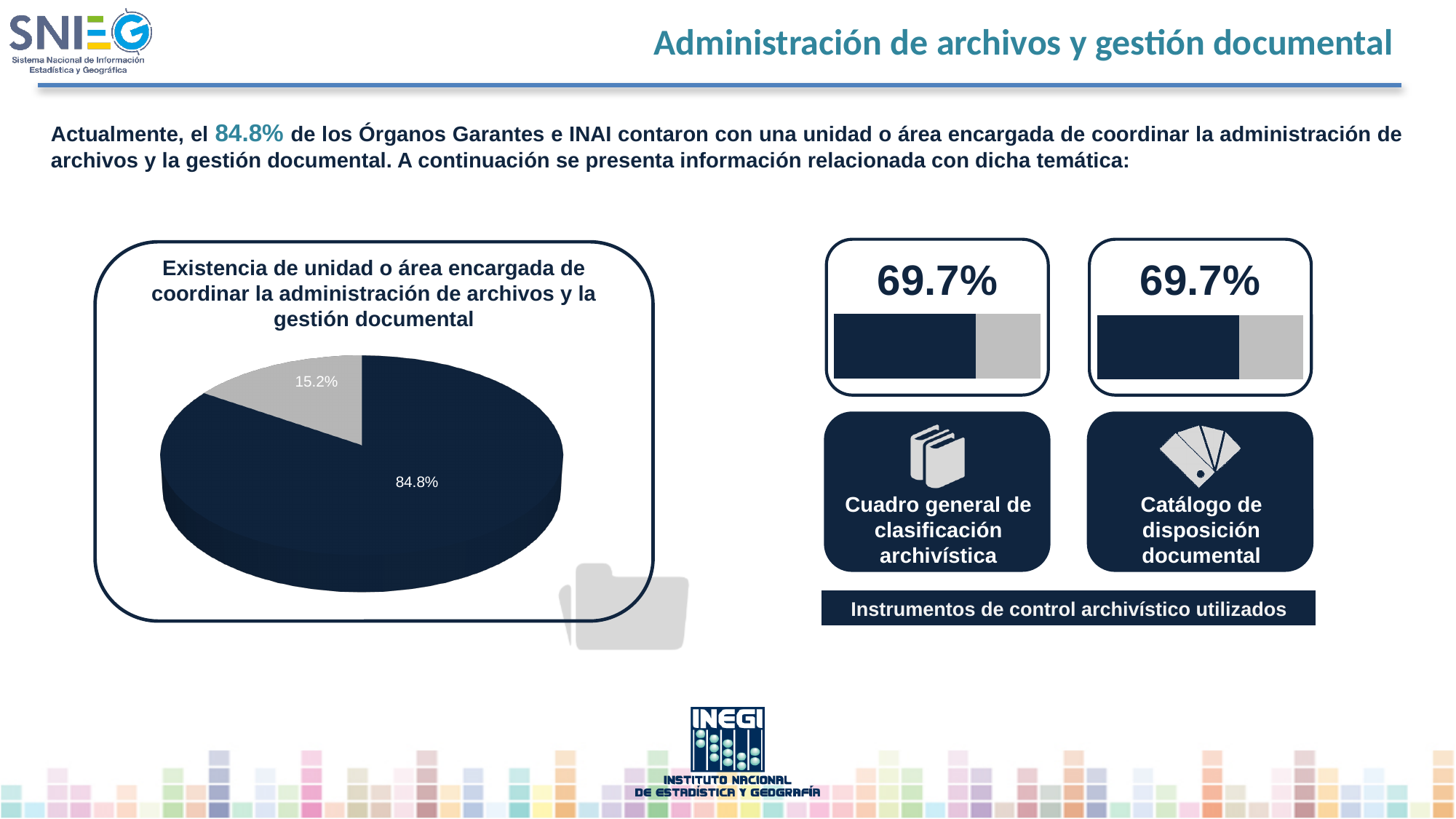
What share of the pie does the gray slice represent? 15.2% What kind of chart is shown on the left side of the slide? Pie chart What percentage is shown above the progress bar for 'Cuadro general de clasificación archivística'? 69.7% How many slices does the pie chart have? 2 What do the two slices of the pie chart add up to? 100% Which slice of the pie chart is the largest? The dark navy slice (84.8%) Which is larger in the pie chart, the dark navy slice or the gray slice? The dark navy slice What is the difference in percentage points between the two slices of the pie chart? 69.6 percentage points What value is shown on the dark navy slice of the pie chart? 84.8% What is the title of the pie chart? Existencia de unidad o área encargada de coordinar la administración de archivos y la gestión documental What value is shown on the gray slice of the pie chart? 15.2% Which slice of the pie chart is the smallest? The gray slice (15.2%)